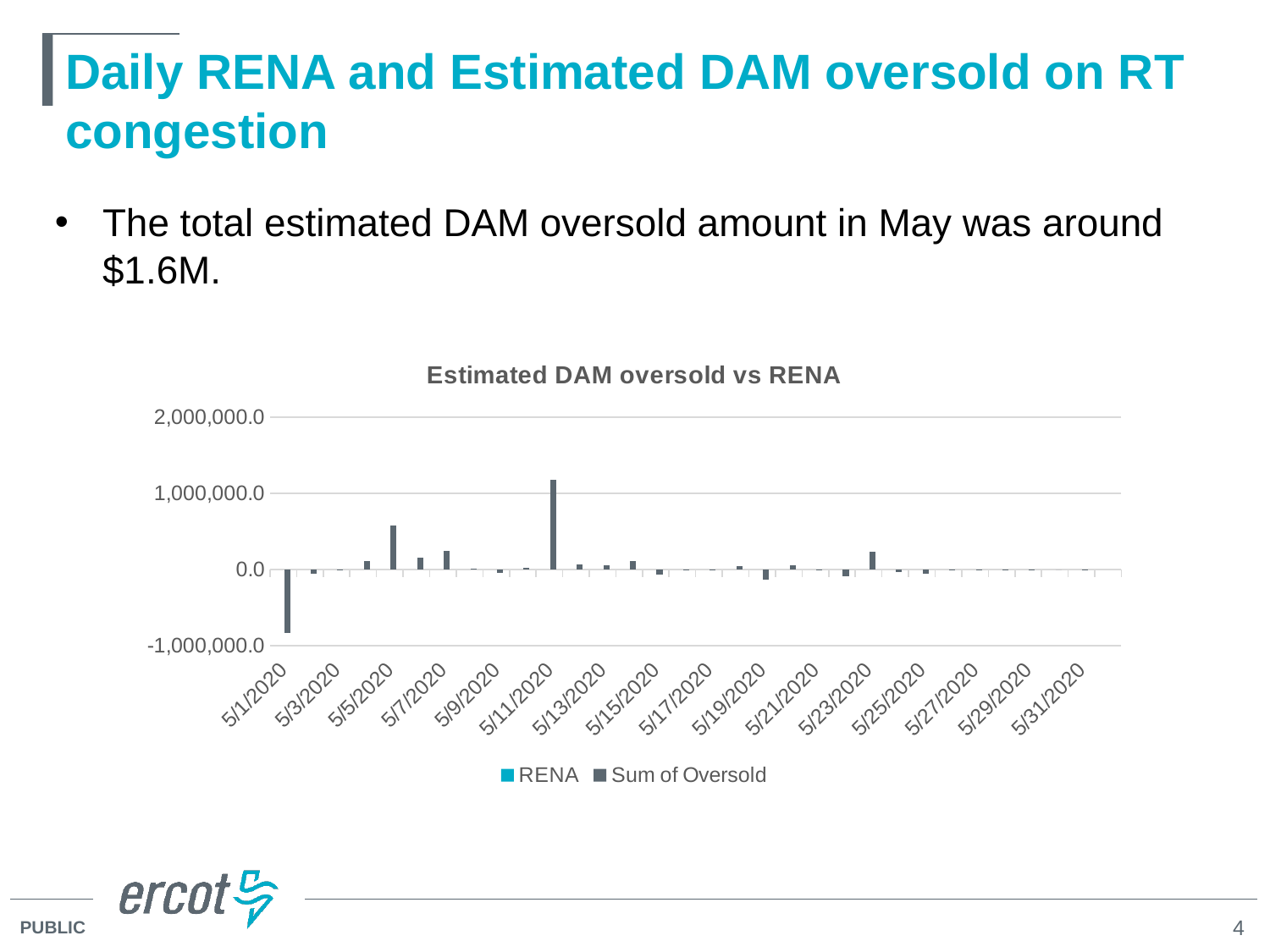
What are the two series named in the legend of the chart? RENA and Sum of Oversold Is the value for 5/1/2020 greater or less than 0.0? less What is the highest value shown on the y axis of the chart? 2,000,000.0 How many date labels are shown along the x axis of the chart? 16 Is the value for 5/31/2020 greater or less than 1,000,000.0? less Which has the larger value, 5/11/2020 or 5/1/2020? 5/11/2020 What kind of chart is shown on the slide? bar chart Is the value for 5/11/2020 greater or less than 1,000,000.0? greater Which date has the tallest positive bar in the chart? 5/11/2020 How many series does the legend of the 'Estimated DAM oversold vs RENA' chart list? 2 Which date has the lowest (most negative) bar in the chart? 5/1/2020